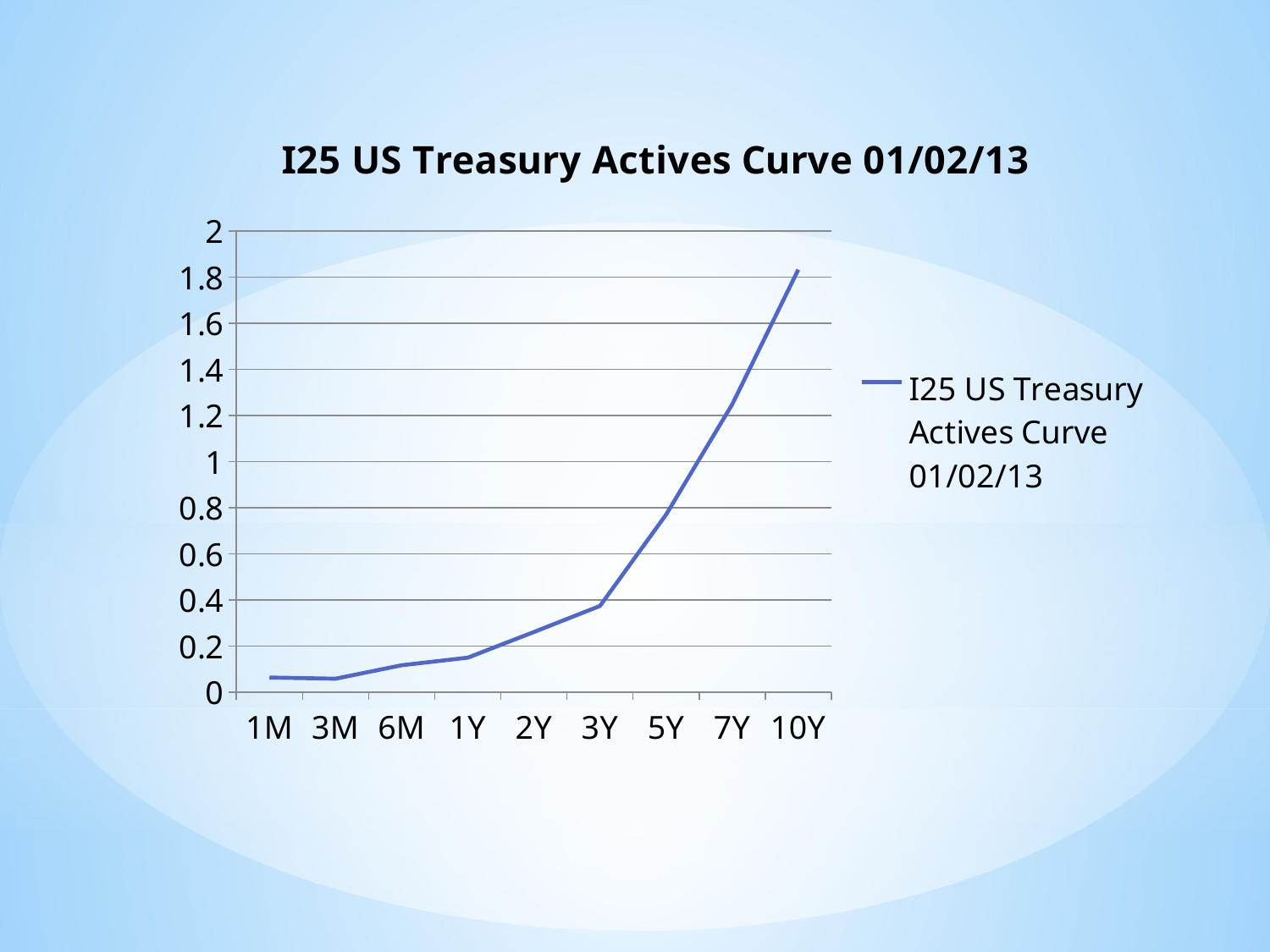
Is the value for 7Y greater or less than 1? greater How many maturity points are plotted along the x axis? 9 Is the value for 5Y greater or less than 1? less Do the values rise or fall as the maturity increases from 1M to 10Y? rise Which has the larger value, 5Y or 3Y? 5Y What colour is the plotted line? blue Is the value for 10Y greater or less than 1.6? greater How many series does the legend list? 1 Which maturity has the highest value on the curve? 10Y What is the title of the chart? I25 US Treasury Actives Curve 01/02/13 What kind of chart is shown on the slide? line chart